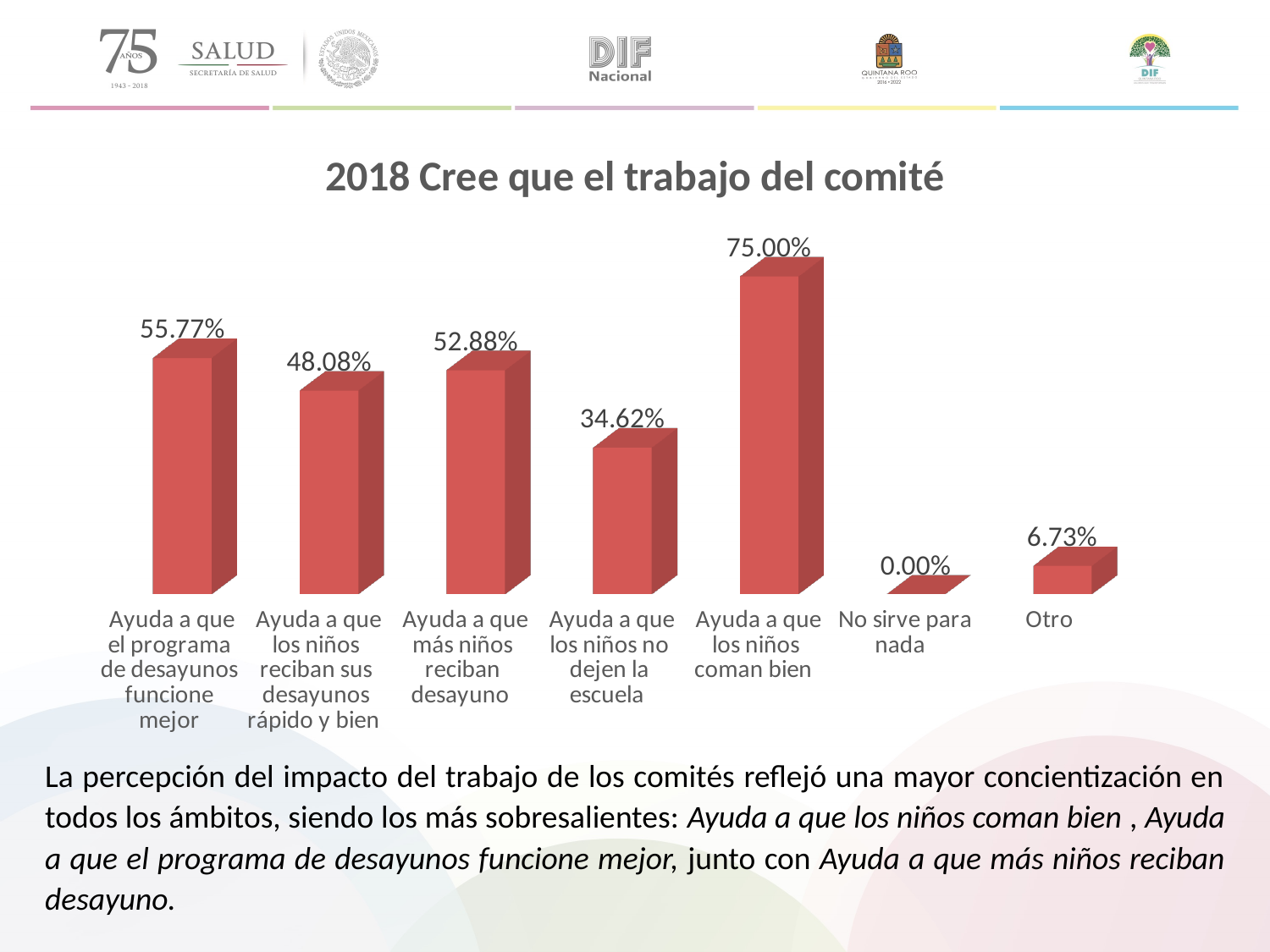
What is the value for "No sirve para nada"? 0.00% What is the difference between "Ayuda a que los niños coman bien" and "Ayuda a que los niños no dejen la escuela"? 40.38% What is the value for "Ayuda a que el programa de desayunos funcione mejor"? 55.77% What is the title of the chart? 2018 Cree que el trabajo del comité Which is larger: "Ayuda a que más niños reciban desayuno" or "Ayuda a que los niños reciban sus desayunos rápido y bien"? Ayuda a que más niños reciban desayuno What is the value for "Ayuda a que los niños coman bien"? 75.00% What is the difference between "Ayuda a que el programa de desayunos funcione mejor" and "Ayuda a que los niños reciban sus desayunos rápido y bien"? 7.69% What kind of chart is shown on the slide? Bar chart Which category has the highest value? Ayuda a que los niños coman bien How many categories are shown in the chart? 7 What is the value for "Otro"? 6.73% Which category has the lowest value? No sirve para nada